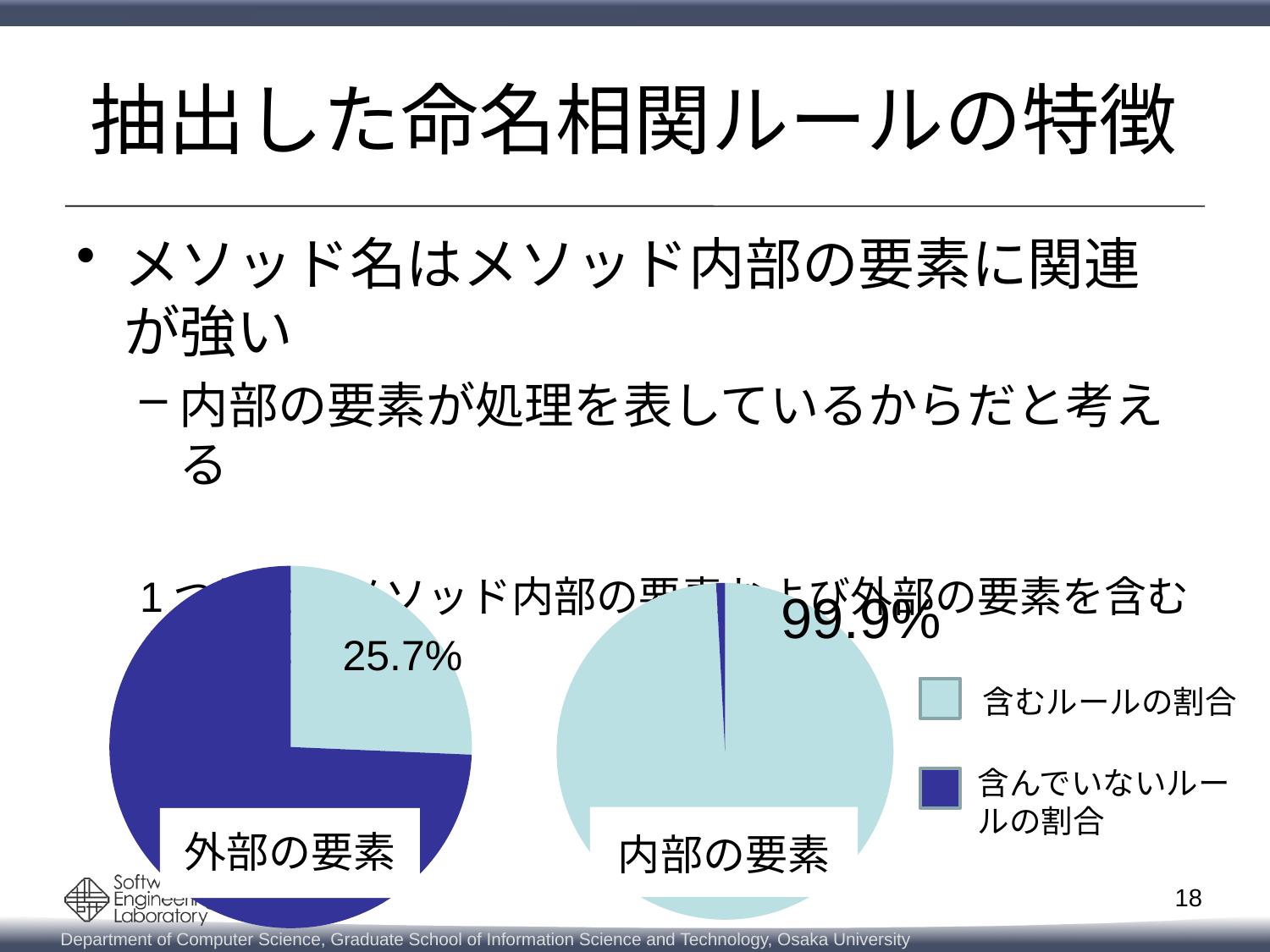
In the pie chart labelled 外部の要素, what percentage is shown for the 含むルールの割合 slice? 25.7% What kind of charts are shown on the slide? Pie charts Is the 含むルールの割合 value in the 外部の要素 chart greater or less than 50%? less What colour represents 含んでいないルールの割合 in the legend? Dark blue How many entries does the legend list? 2 In the 内部の要素 pie chart, which slice is smaller, 含むルールの割合 or 含んでいないルールの割合? 含んでいないルールの割合 In the pie chart labelled 内部の要素, what percentage is shown for the 含むルールの割合 slice? 99.9% Which pie chart has the larger 含むルールの割合 slice, 外部の要素 or 内部の要素? 内部の要素 What is the difference between the 含むルールの割合 percentages of the 内部の要素 chart and the 外部の要素 chart? 74.2% How many pie charts are on the slide? 2 What colour represents 含むルールの割合 in the legend? Light blue In the 外部の要素 pie chart, which slice is larger, 含むルールの割合 or 含んでいないルールの割合? 含んでいないルールの割合